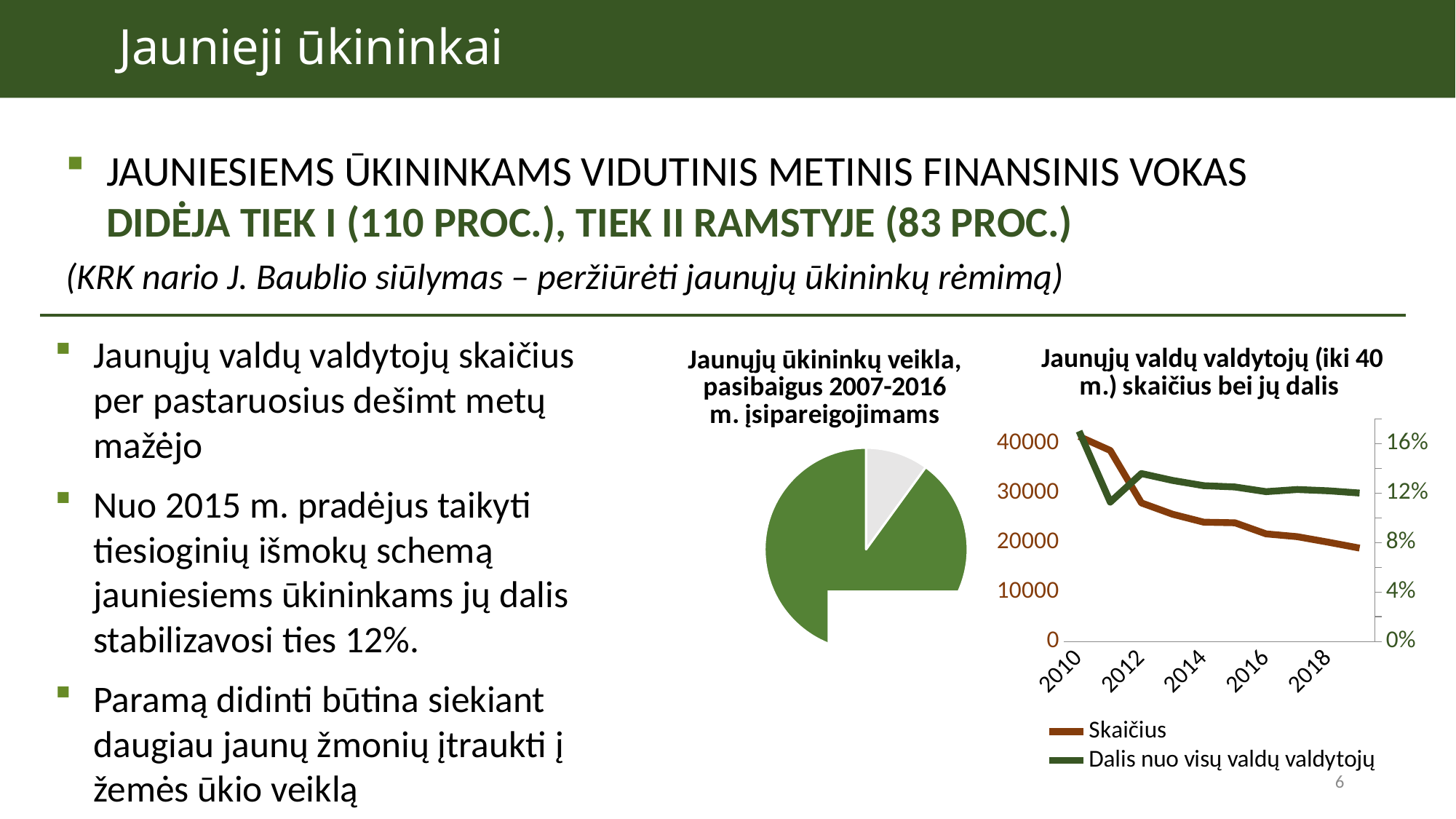
In the line chart on the right, what are the two series named in the legend? Skaičius; Dalis nuo visų valdų valdytojų In the line chart on the right, how many series does the legend list? 2 In the line chart on the right, is the Dalis nuo visų valdų valdytojų value for 2018 greater or less than 16%? less What kind of chart is the chart titled "Jaunųjų valdų valdytojų (iki 40 m.) skaičius bei jų dalis"? line chart In the line chart on the right, is the Dalis nuo visų valdų valdytojų value for 2010 greater or less than 12%? greater In the line chart on the right, is the Skaičius value for 2012 greater or less than 30000? less In the line chart on the right, which series is drawn in brown? Skaičius What kind of chart is the chart titled "Jaunųjų ūkininkų veikla, pasibaigus 2007-2016 m. įsipareigojimams"? pie chart In the line chart on the right, does the Skaičius series rise or fall from 2010 to 2018? fall